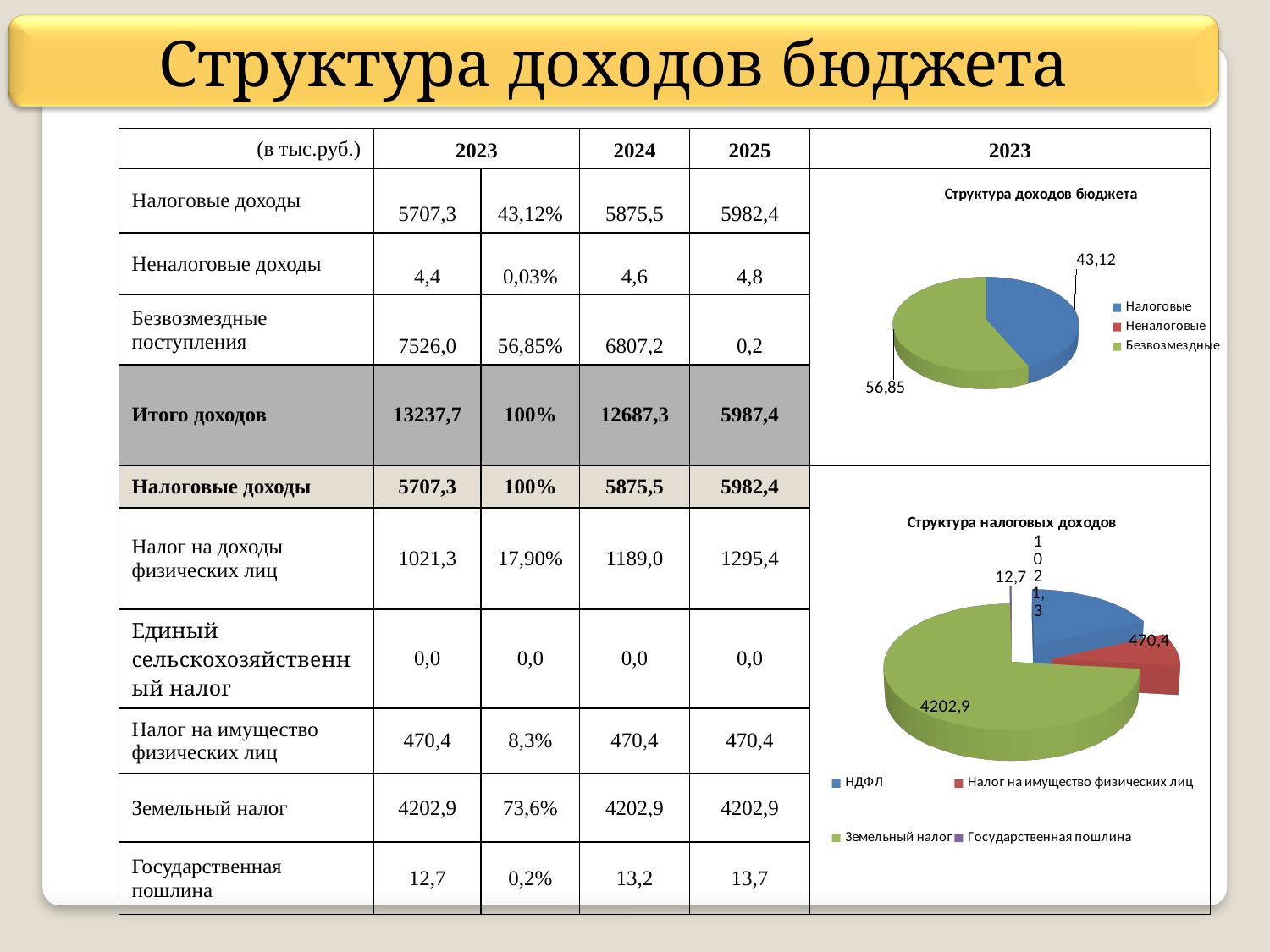
What type of chart is the chart titled "Структура доходов бюджета"? pie chart In the chart titled "Структура доходов бюджета", what is the difference between the Безвозмездные and Налоговые labels? 13,73 In the chart titled "Структура налоговых доходов", what value is labelled on the Земельный налог slice? 4202,9 In the chart titled "Структура доходов бюджета", what value is labelled on the Безвозмездные slice? 56,85 How many entries does the legend of the chart titled "Структура налоговых доходов" list? 4 What type of chart is the chart titled "Структура налоговых доходов"? pie chart In the chart titled "Структура налоговых доходов", what value is labelled on the Налог на имущество физических лиц slice? 470,4 How many entries does the legend of the chart titled "Структура доходов бюджета" list? 3 In the chart titled "Структура налоговых доходов", what value is labelled on the Государственная пошлина slice? 12,7 In the chart titled "Структура доходов бюджета", what value is labelled on the Налоговые slice? 43,12 In the chart titled "Структура доходов бюджета", which slice is the largest? Безвозмездные In the chart titled "Структура налоговых доходов", which slice is the smallest? Государственная пошлина